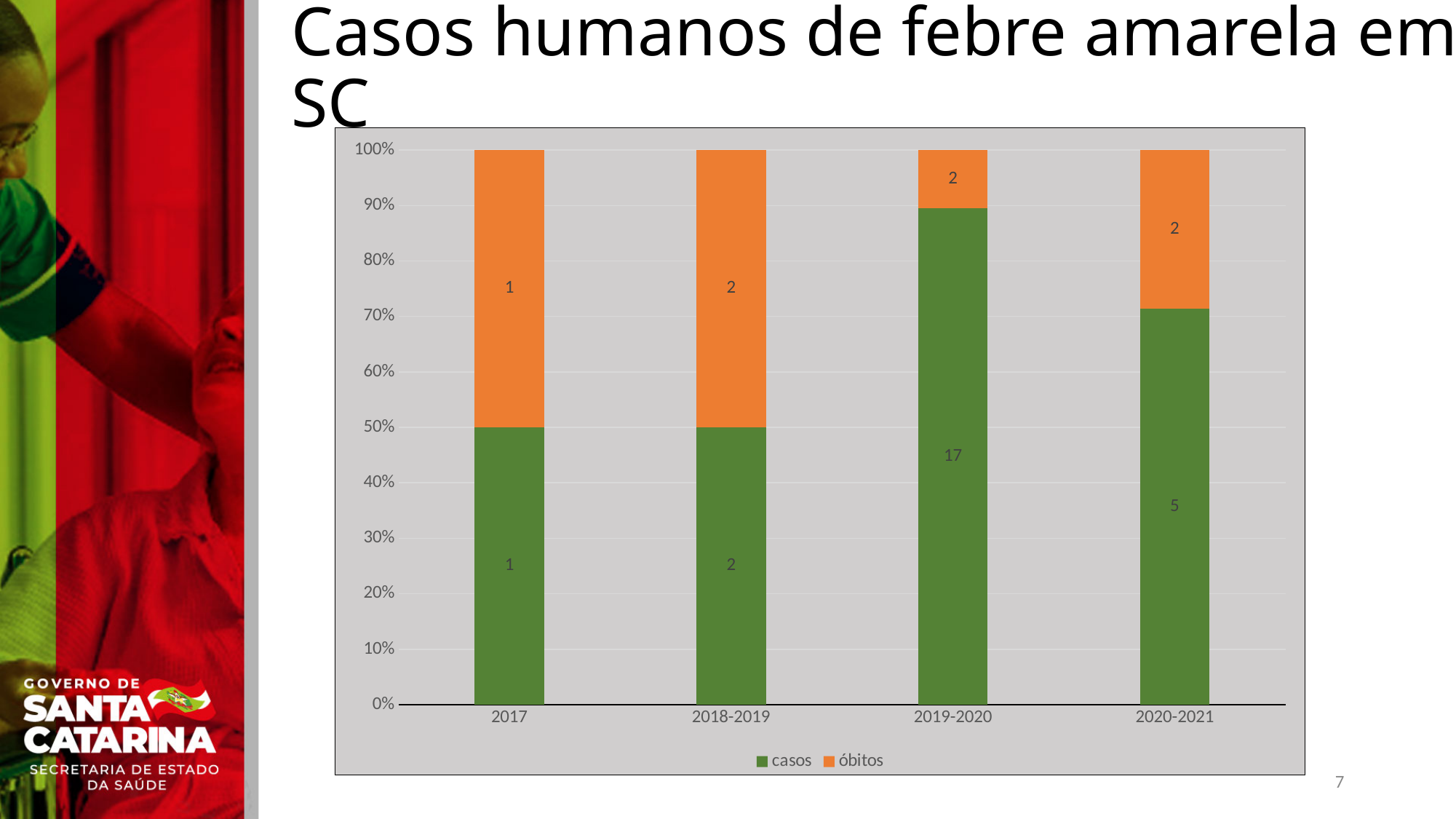
How many series does the legend list? 2 Is the share of casos in the 2019-2020 bar greater or less than 80%? greater What is the value for casos in 2020-2021? 5 Which period has the lowest value for casos? 2017 What is the value for óbitos in 2018-2019? 2 What is the sum of casos and óbitos labelled in the 2019-2020 bar? 19 Which is larger: casos in 2018-2019 or casos in 2020-2021? casos in 2020-2021 Which period has the highest value for casos? 2019-2020 How many periods are shown on the x axis? 4 What is the value for casos in 2019-2020? 17 What is the value for óbitos in 2017? 1 What is the difference between casos in 2019-2020 and casos in 2020-2021? 12